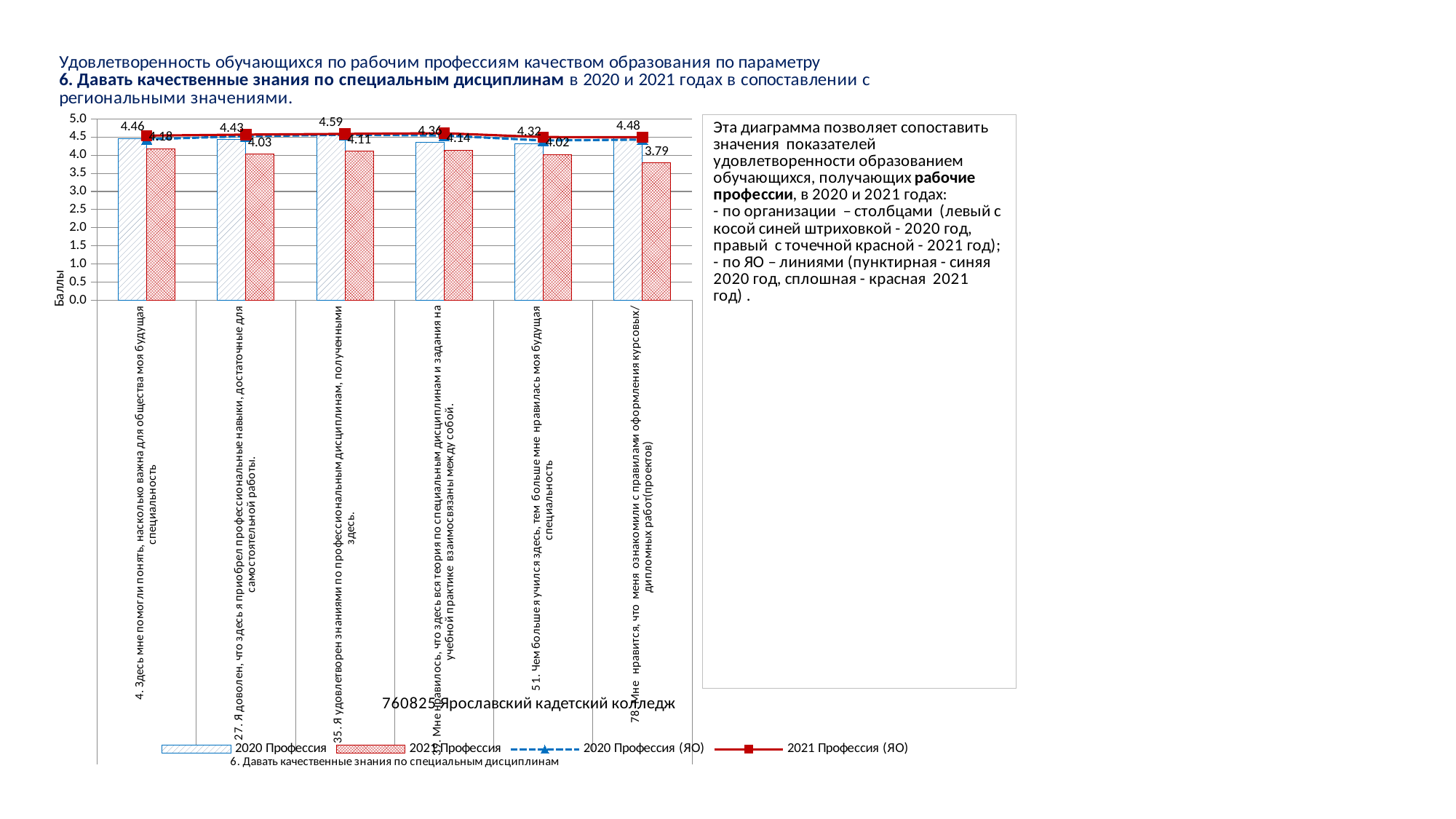
What is the label of the vertical axis of the chart? Баллы Which category has the highest 2020 Профессия value? 35. Я удовлетворен знаниями по профессиональным дисциплинам, полученными здесь. What is the 2021 Профессия value for category "78. Мне нравится, что меня ознакомили с правилами оформления курсовых/дипломных работ(проектов)"? 3.79 What is the 2021 Профессия value for category "27. Я доволен, что здесь я приобрел профессиональные навыки, достаточные для самостоятельной работы."? 4.03 Is the 2021 Профессия value for category "35. Я удовлетворен знаниями по профессиональным дисциплинам, полученными здесь." greater or less than 4.0? greater Which is larger for category "51. Чем больше я учился здесь, тем больше мне нравилась моя будущая специальность": the 2020 Профессия value or the 2021 Профессия value? 2020 Профессия What is the difference between the 2020 Профессия and 2021 Профессия values for category "78. Мне нравится, что меня ознакомили с правилами оформления курсовых/дипломных работ(проектов)"? 0.69 How many categories are shown on the x axis of the chart? 6 What kind of chart is shown on the slide? Combined bar and line chart How many series does the chart legend list? 4 Which category has the lowest 2021 Профессия value? 78. Мне нравится, что меня ознакомили с правилами оформления курсовых/дипломных работ(проектов) What is the 2020 Профессия value for category "4. Здесь мне помогли понять, насколько важна для общества моя будущая специальность"? 4.46